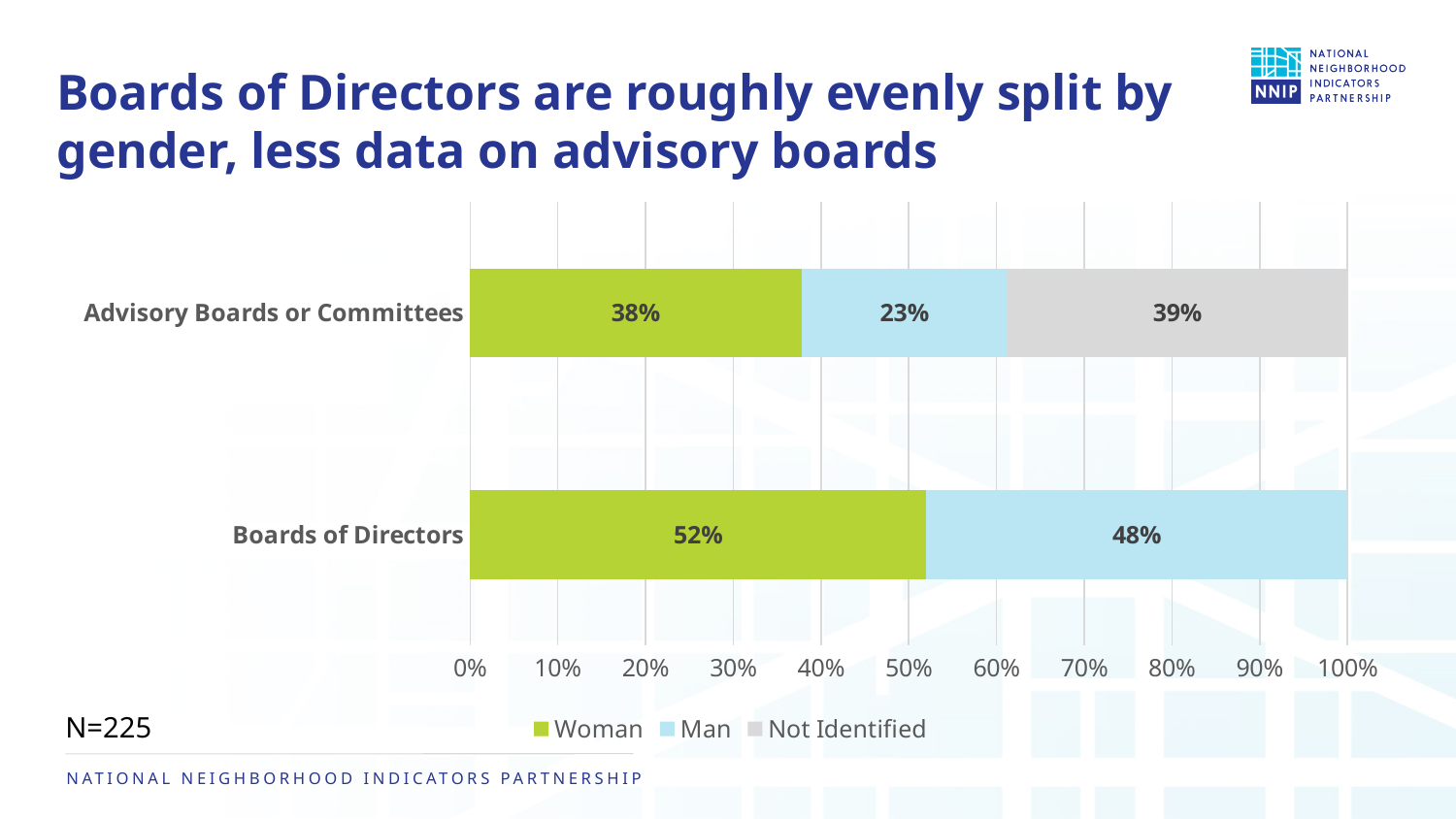
What is the difference between the Woman shares of Boards of Directors and Advisory Boards or Committees? 14% Which category has the higher Woman share, Advisory Boards or Committees or Boards of Directors? Boards of Directors What is the difference between the Woman and Man shares for Boards of Directors? 4% How many categories are shown on the chart? 2 What kind of chart is shown on the slide? Stacked bar chart What is the Not Identified share for Advisory Boards or Committees? 39% What is the total of the stacked bar for Advisory Boards or Committees? 100% What is the sample size (N) noted on the slide? N=225 What is the Woman share for Boards of Directors? 52% What percentage of Boards of Directors members are men? 48% How many series does the legend list? 3 What percentage of Advisory Boards or Committees members are women? 38%